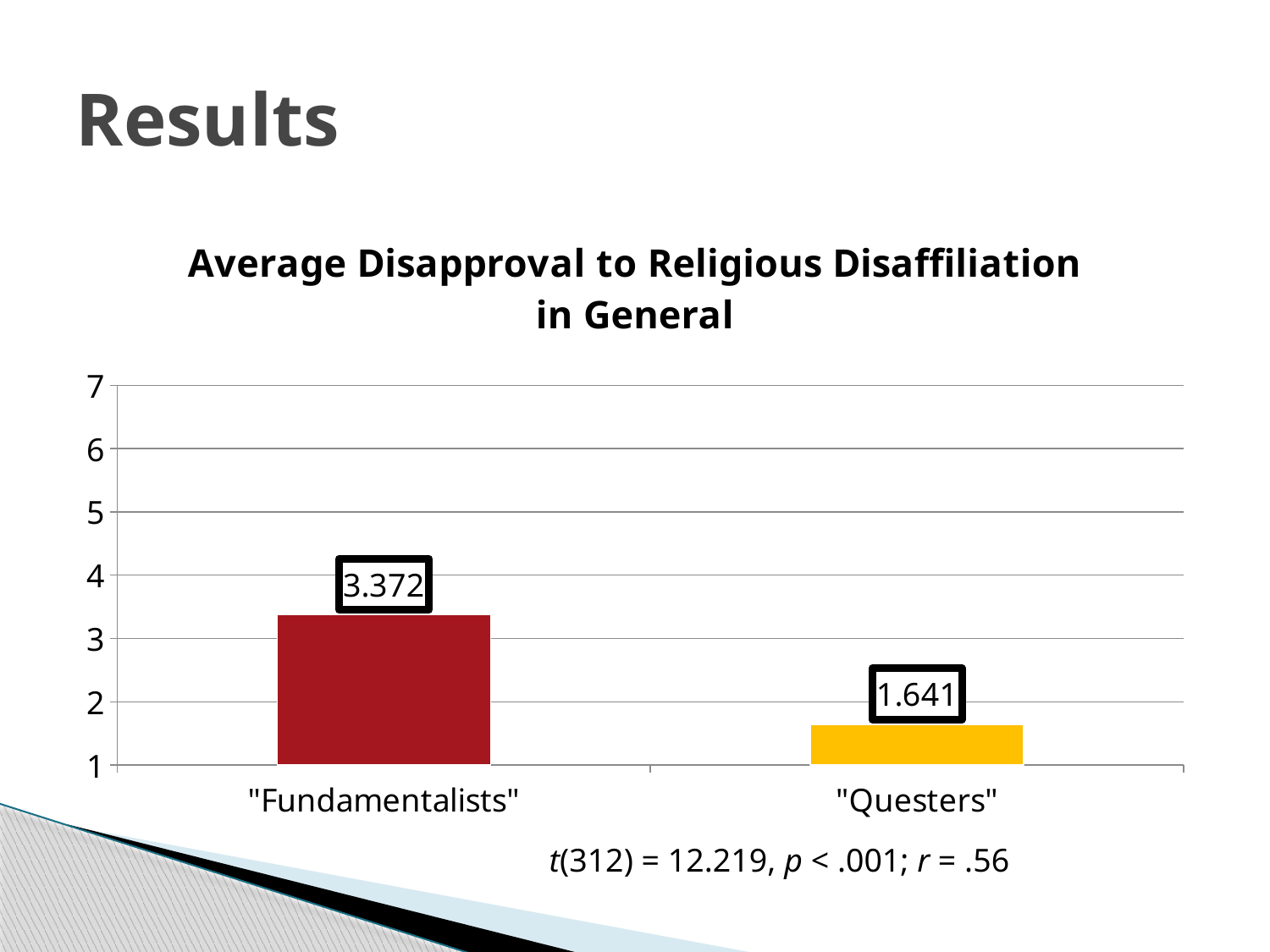
Which group has the higher average disapproval to religious disaffiliation? "Fundamentalists" What is the average disapproval value for "Fundamentalists"? 3.372 What colour is the bar for "Questers"? yellow What is the difference between the "Fundamentalists" and "Questers" values? 1.731 What kind of chart is shown on the slide? bar chart Which group has the lower average disapproval to religious disaffiliation? "Questers" Is the value for "Questers" greater or less than 2? less Is the value for "Fundamentalists" greater or less than 3? greater What is the title of the chart? Average Disapproval to Religious Disaffiliation in General How many categories are shown on the chart? 2 Is the value for "Fundamentalists" larger or smaller than the value for "Questers"? larger What is the average disapproval value for "Questers"? 1.641